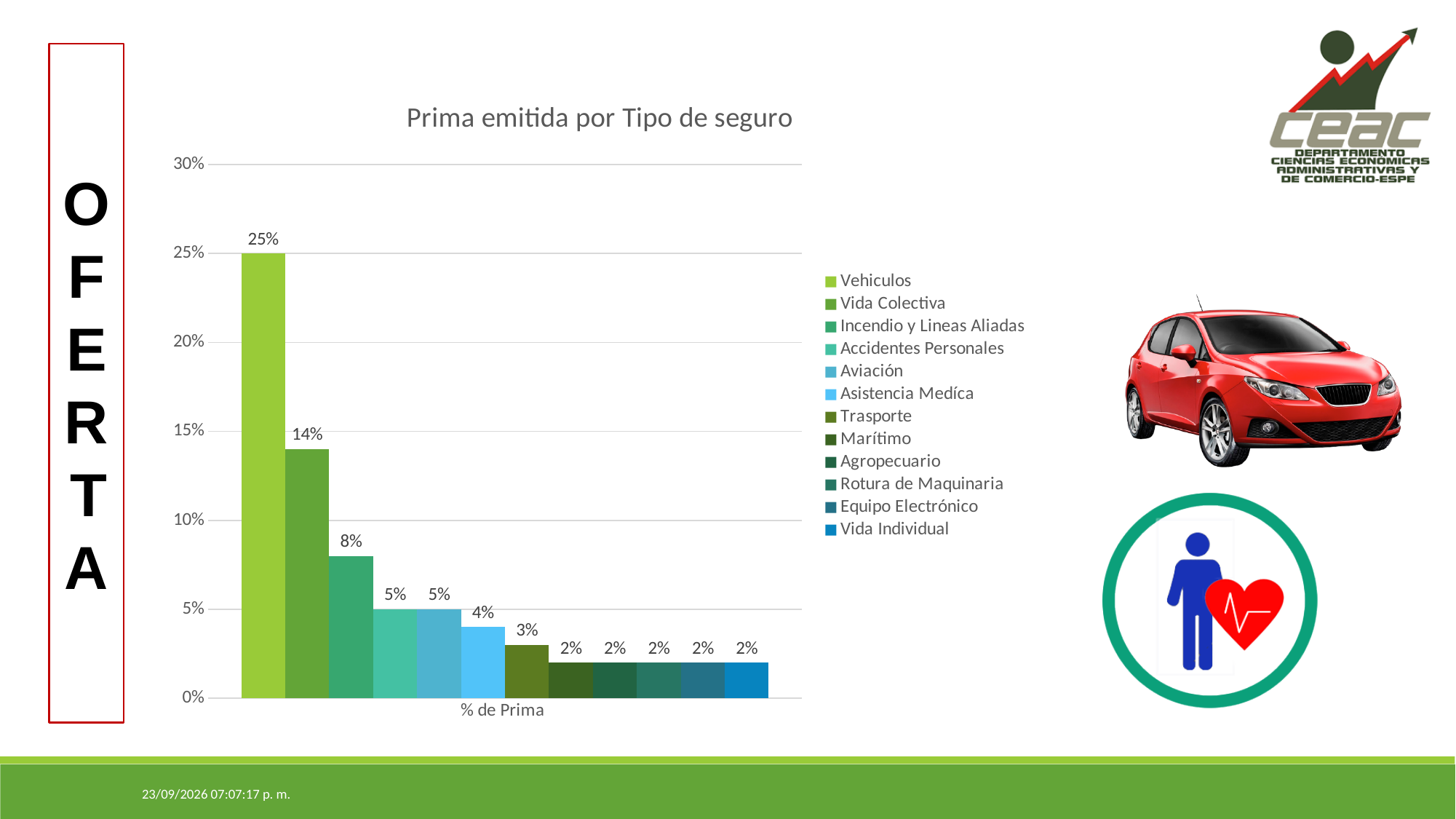
What is the value for Vehiculos in the chart? 25% Which is larger, the value for Incendio y Lineas Aliadas or the value for Aviación? Incendio y Lineas Aliadas How many series does the legend list? 12 Which type of insurance has the highest share of prima emitida? Vehiculos What is the value for Incendio y Lineas Aliadas? 8% What kind of chart is shown on the slide? Bar chart What is the value for Trasporte? 3% What is the value for Asistencia Medíca? 4% What is the label shown on the x axis of the chart? % de Prima What is the difference between the values for Vehiculos and Vida Colectiva? 11% What is the title of the chart? Prima emitida por Tipo de seguro What is the value for Vida Colectiva? 14%